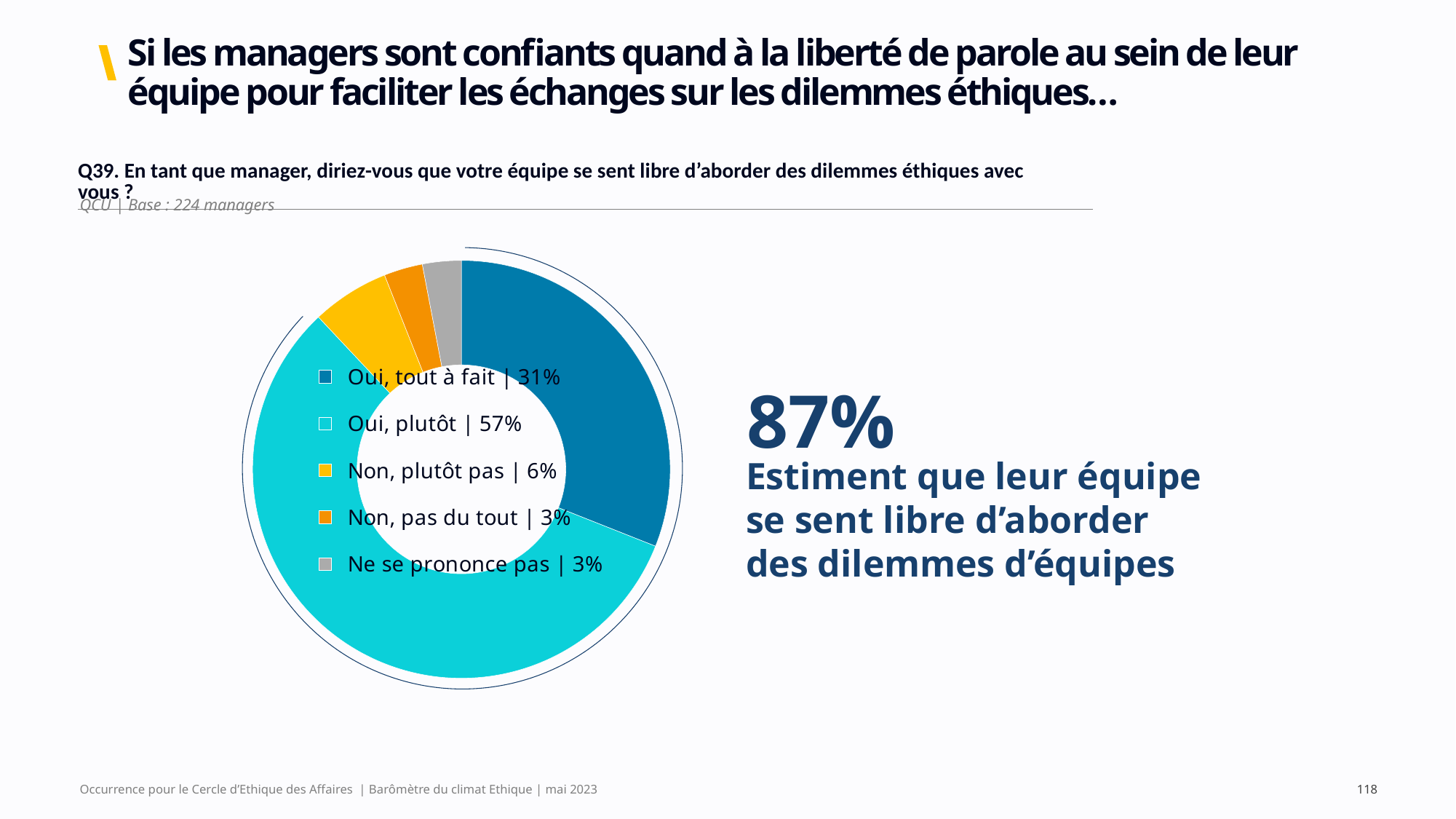
Which response category has the largest share of the pie? Oui, plutôt What percentage of managers answered "Oui, tout à fait"? 31% What is the combined share of "Oui, tout à fait" and "Oui, plutôt"? 88% Which is larger: the share for "Non, plutôt pas" or the share for "Non, pas du tout"? Non, plutôt pas What is the difference in percentage points between "Oui, plutôt" and "Oui, tout à fait"? 26 What kind of chart is shown on the slide? Pie chart (doughnut) What large percentage is highlighted to the right of the chart? 87% What percentage of managers answered "Non, plutôt pas"? 6% How many response categories does the legend list? 5 What percentage of managers answered "Oui, plutôt"? 57% What percentage of managers answered "Ne se prononce pas"? 3% What is the base (number of respondents) stated for this question? 224 managers